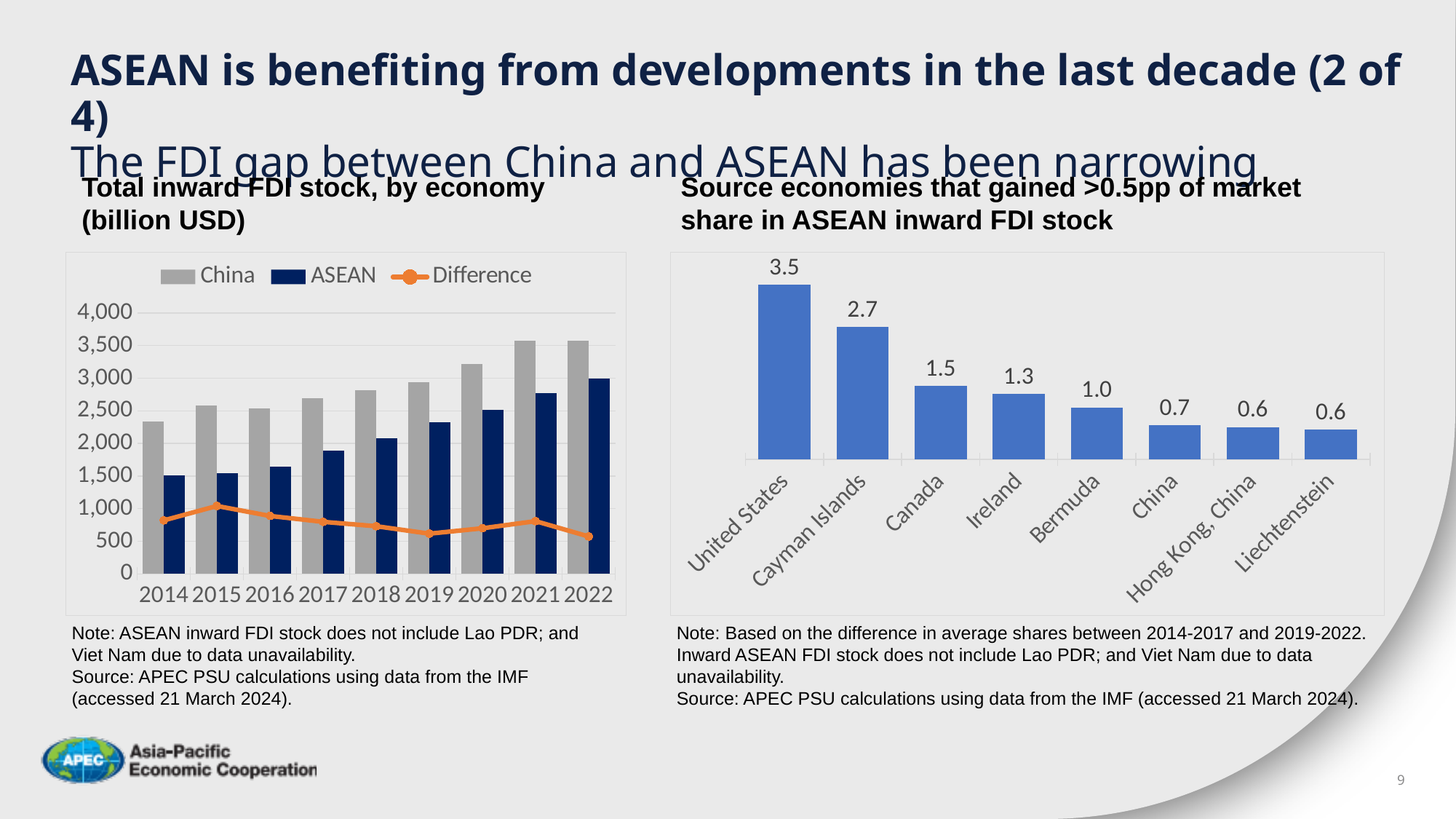
In the chart 'Total inward FDI stock, by economy (billion USD)', is the ASEAN value for 2014 greater or less than 2,000? less How many years are shown on the x axis of the chart 'Total inward FDI stock, by economy (billion USD)'? 9 How many economies are shown in the chart 'Source economies that gained >0.5pp of market share in ASEAN inward FDI stock'? 8 In the chart 'Source economies that gained >0.5pp of market share in ASEAN inward FDI stock', which economy has the highest value? United States In the chart 'Source economies that gained >0.5pp of market share in ASEAN inward FDI stock', what is the value for the United States? 3.5 How many series does the legend list in the chart 'Total inward FDI stock, by economy (billion USD)'? 3 In the chart 'Source economies that gained >0.5pp of market share in ASEAN inward FDI stock', what is the value for Bermuda? 1.0 In the chart 'Source economies that gained >0.5pp of market share in ASEAN inward FDI stock', what is the difference between the values for the United States and the Cayman Islands? 0.8 In the chart 'Total inward FDI stock, by economy (billion USD)', do the ASEAN values rise or fall from 2014 to 2022? rise In the chart 'Source economies that gained >0.5pp of market share in ASEAN inward FDI stock', what is the value for Canada? 1.5 In the chart 'Total inward FDI stock, by economy (billion USD)', is the ASEAN value for 2022 greater or less than 2,500? greater In the chart 'Source economies that gained >0.5pp of market share in ASEAN inward FDI stock', which is larger, the value for Ireland or the value for China? Ireland